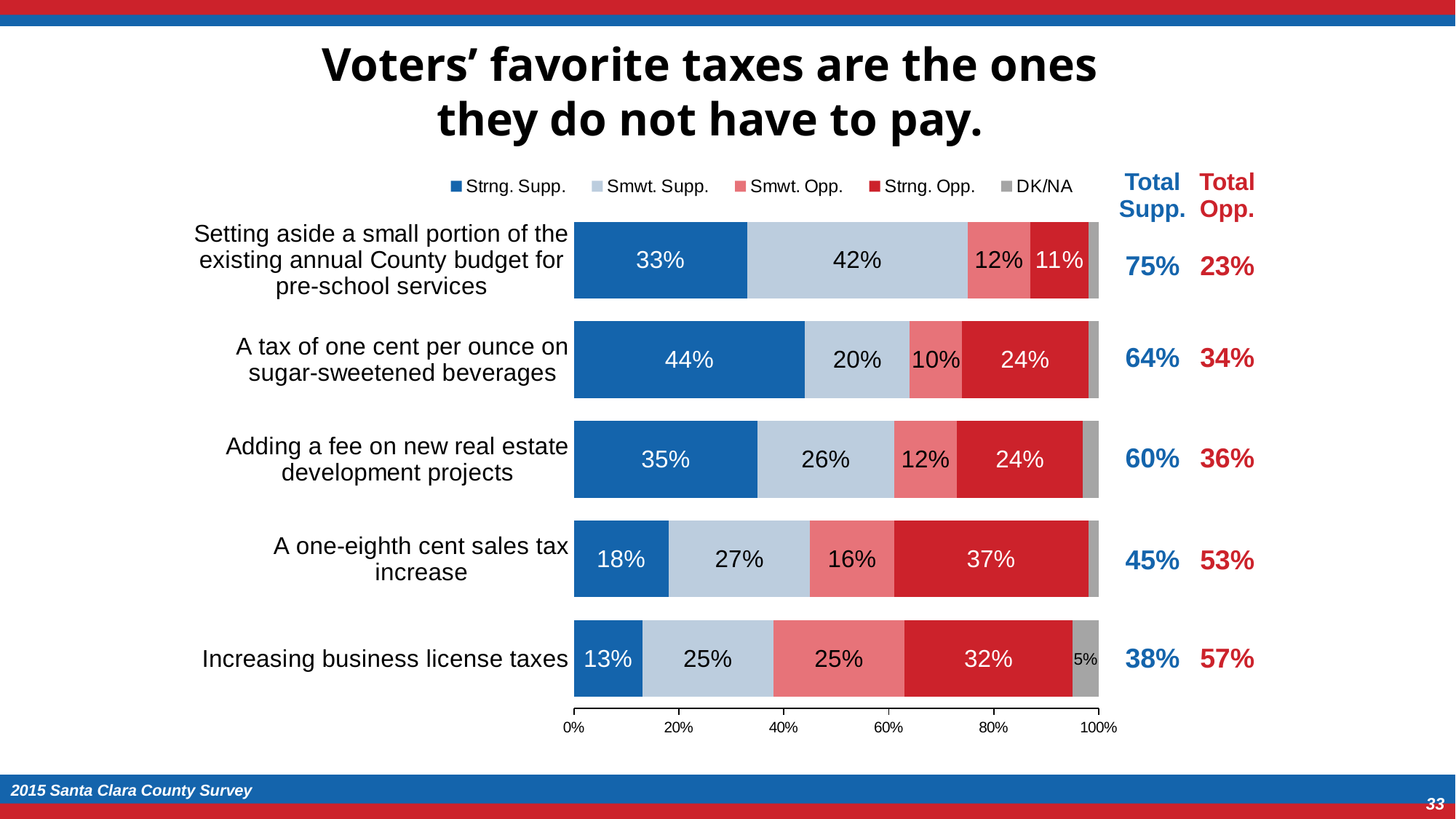
How many tax proposals are shown in the chart? 5 Which proposal has the highest Strng. Supp. value? A tax of one cent per ounce on sugar-sweetened beverages What is the Total Supp. value for setting aside a small portion of the existing annual County budget for pre-school services? 75% What percentage strongly support a tax of one cent per ounce on sugar-sweetened beverages? 44% How many percentage points higher is the Smwt. Supp. value for the pre-school services proposal than for the real estate development fee? 16 How many series does the legend list? 5 What is the DK/NA value shown for increasing business license taxes? 5% What kind of chart is shown on the slide? Stacked bar chart Which proposal has the highest Strng. Opp. value? A one-eighth cent sales tax increase Which proposal has the lowest Strng. Supp. value? Increasing business license taxes Which has a larger Strng. Opp. value: adding a fee on new real estate development projects or increasing business license taxes? Increasing business license taxes What is the Strng. Opp. value for a one-eighth cent sales tax increase? 37%